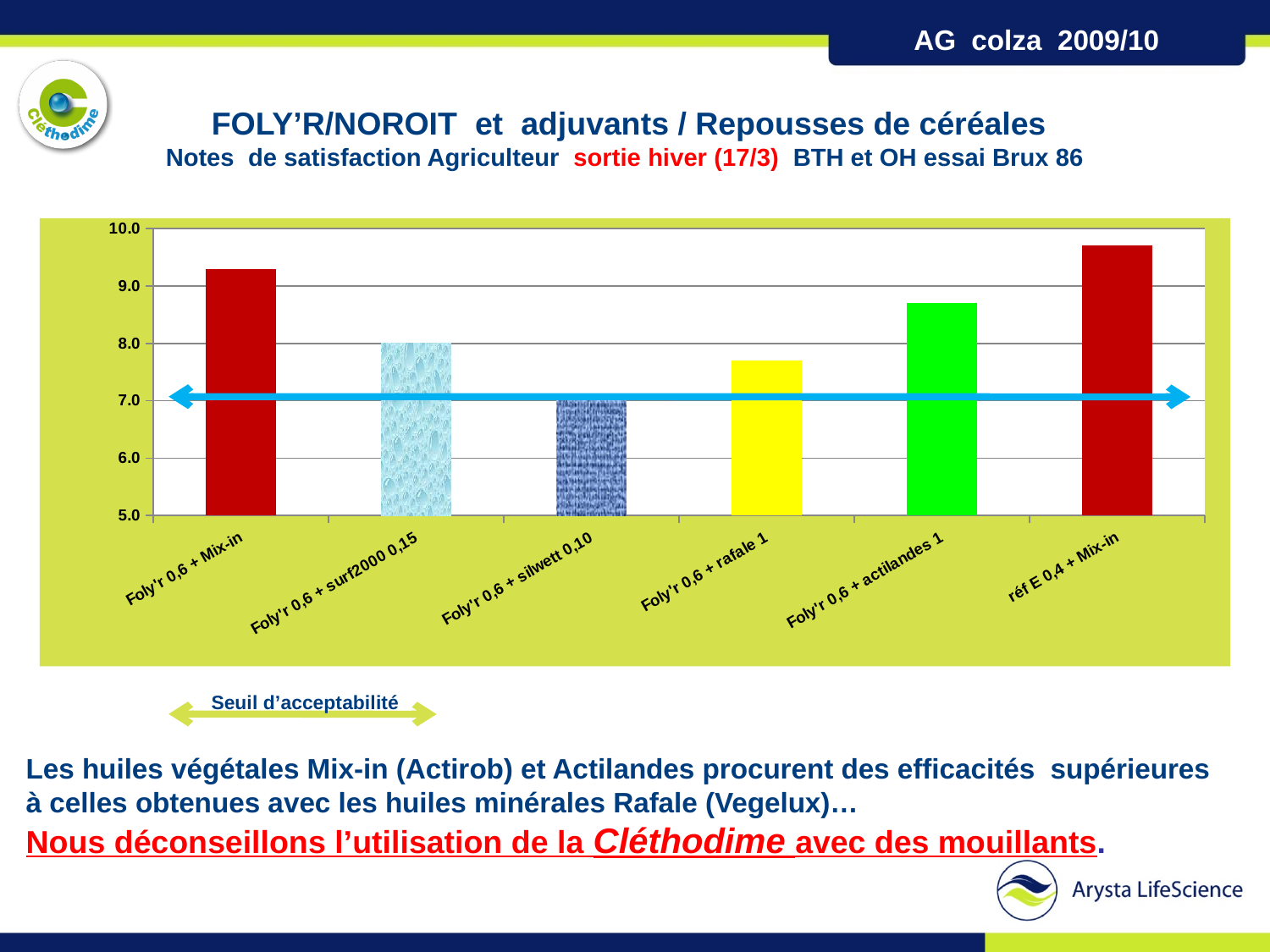
Which is larger, the value for Foly'r 0,6 + Mix-in or the value for Foly'r 0,6 + actilandes 1? Foly'r 0,6 + Mix-in What does the horizontal blue arrow line across the chart represent, according to the label below the chart? Seuil d'acceptabilité Is the value for Foly'r 0,6 + silwett 0,10 greater or less than 8.0? less What is the lowest value shown on the vertical axis of the chart? 5.0 Is the value for Foly'r 0,6 + rafale 1 greater or less than 8.0? less Which category has the lowest bar in the chart? Foly'r 0,6 + silwett 0,10 Which category has the highest bar in the chart? réf E 0,4 + Mix-in What kind of chart is shown on the slide? bar chart How many categories (bars) are plotted in the chart? 6 Is the value for réf E 0,4 + Mix-in greater or less than 9.0? greater